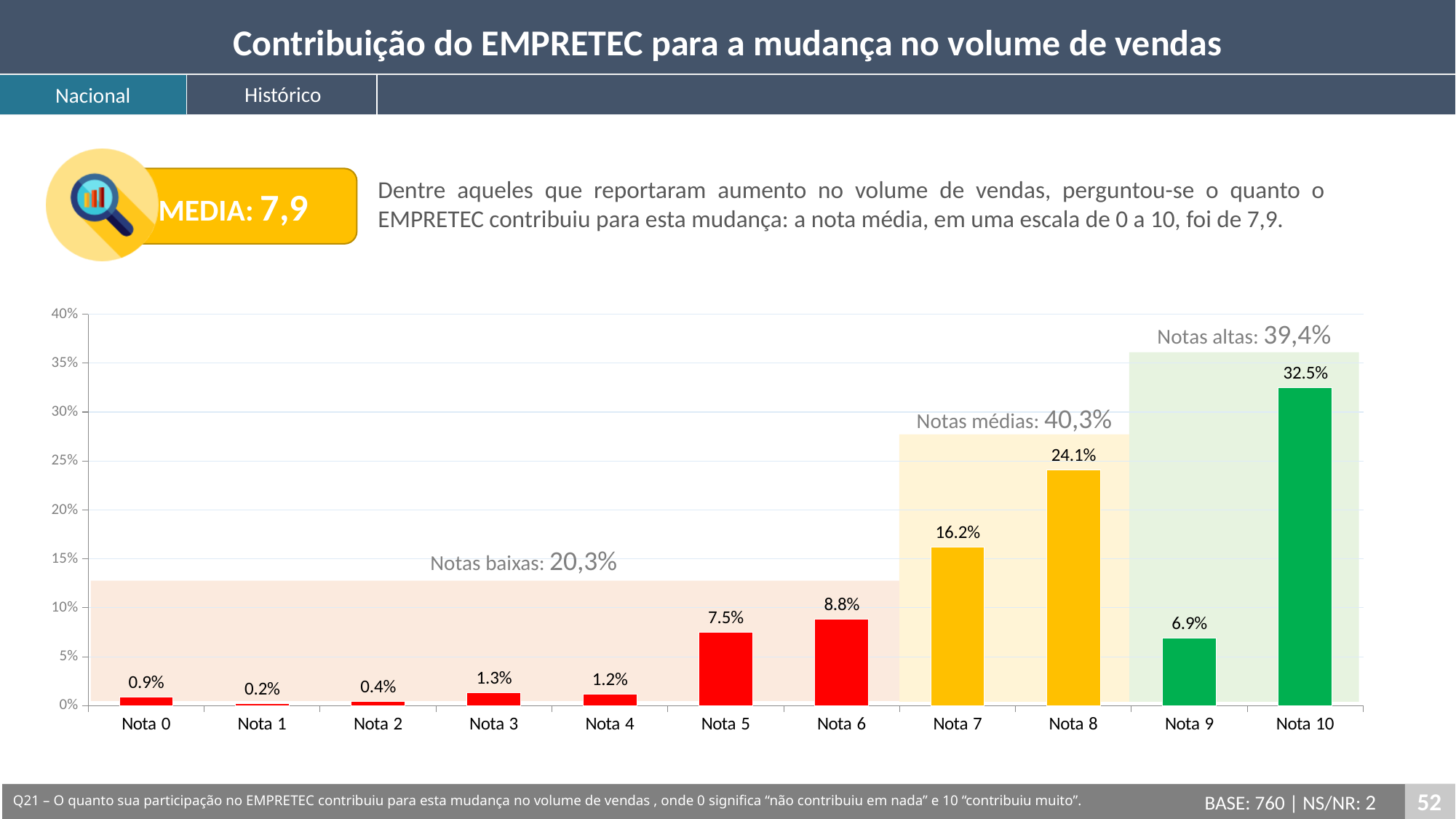
What is the value for Nota 1? 0.2% How many categories are shown on the x axis? 11 What kind of chart is shown on the slide? bar chart What is the total of the values for Nota 9 and Nota 10? 39.4% What is the value for Nota 7? 16.2% Which category has the highest value? Nota 10 What is the value for Nota 10? 32.5% Is the value for Nota 8 greater or less than 20%? greater Which is larger, the value for Nota 6 or the value for Nota 9? Nota 6 What percentage is shown for the 'Notas médias' group? 40,3% Which category has the lowest value? Nota 1 What is the difference between the values for Nota 10 and Nota 8? 8.4%